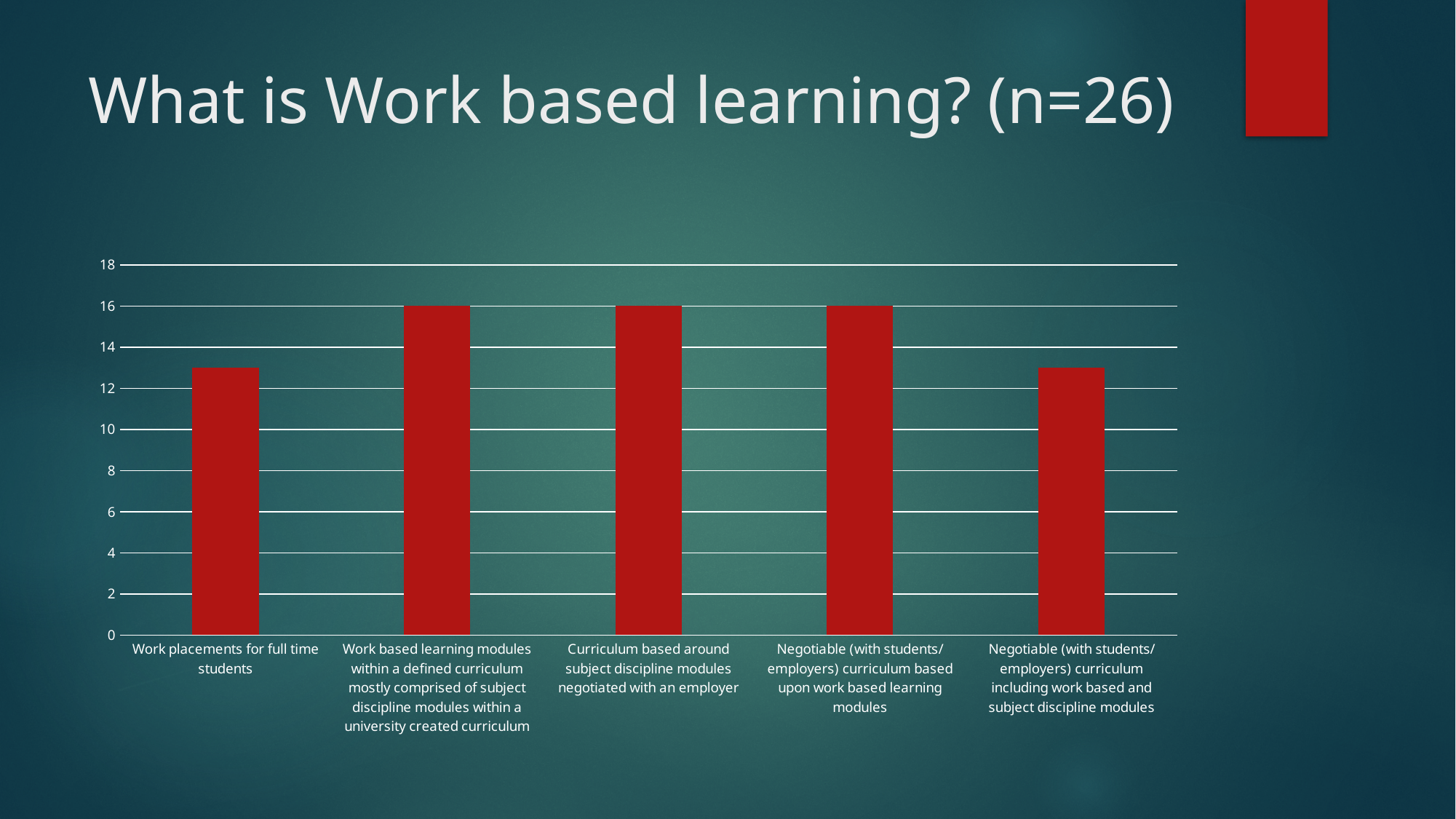
What is the value for 'Negotiable (with students/employers) curriculum based upon work based learning modules'? 16 Which is larger: the value for 'Work placements for full time students' or the value for 'Curriculum based around subject discipline modules negotiated with an employer'? Curriculum based around subject discipline modules negotiated with an employer What is the difference between the values for 'Curriculum based around subject discipline modules negotiated with an employer' and 'Negotiable (with students/employers) curriculum based upon work based learning modules'? 0 How many categories are shown on the x axis of the chart? 5 What is the highest value shown on the chart's vertical axis? 18 Is the value for 'Work placements for full time students' greater or less than 12? greater Is the value for 'Negotiable (with students/employers) curriculum including work based and subject discipline modules' greater or less than 14? less What is the value for 'Work based learning modules within a defined curriculum mostly comprised of subject discipline modules within a university created curriculum'? 16 Is the value for 'Work placements for full time students' greater or less than 14? less What type of chart is shown on the slide? bar chart What is the value for 'Curriculum based around subject discipline modules negotiated with an employer'? 16 What is the title of the slide containing the chart? What is Work based learning? (n=26)